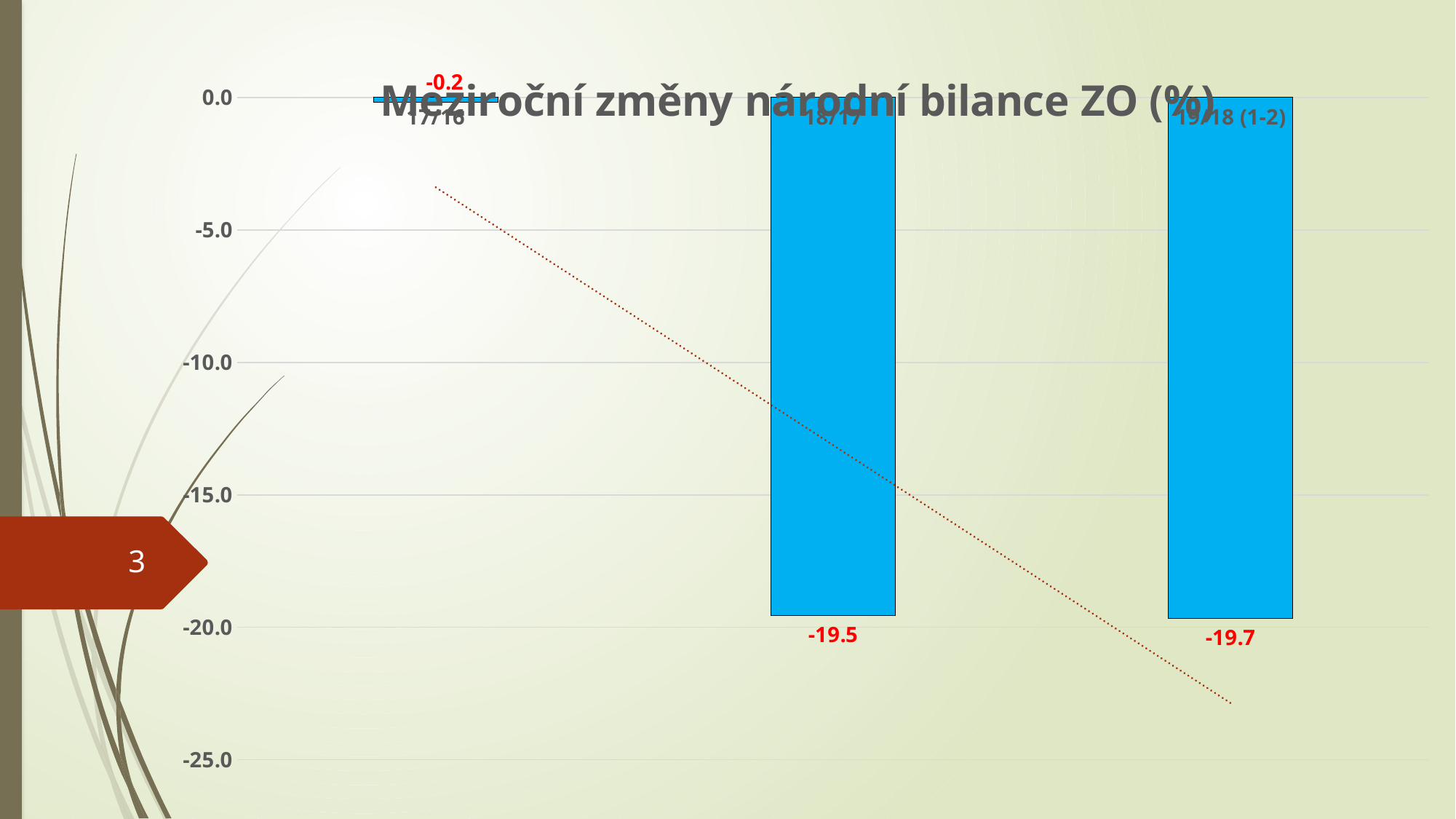
Do the values rise or fall from 17/16 to 19/18 (1-2)? fall What is the difference between the values for 17/16 and 18/17? 19.3 Which category has the highest value? 17/16 What is the value for 18/17? -19.5 What is the title of the chart? Meziroční změny národní bilance ZO (%) How many categories are plotted in the chart? 3 What is the value for 19/18 (1-2)? -19.7 What type of chart is shown on the slide? bar chart What is the value for 17/16? -0.2 Which is larger, the value for 17/16 or the value for 18/17? 17/16 Which category has the lowest value? 19/18 (1-2) What is the difference between the values for 18/17 and 19/18 (1-2)? 0.2